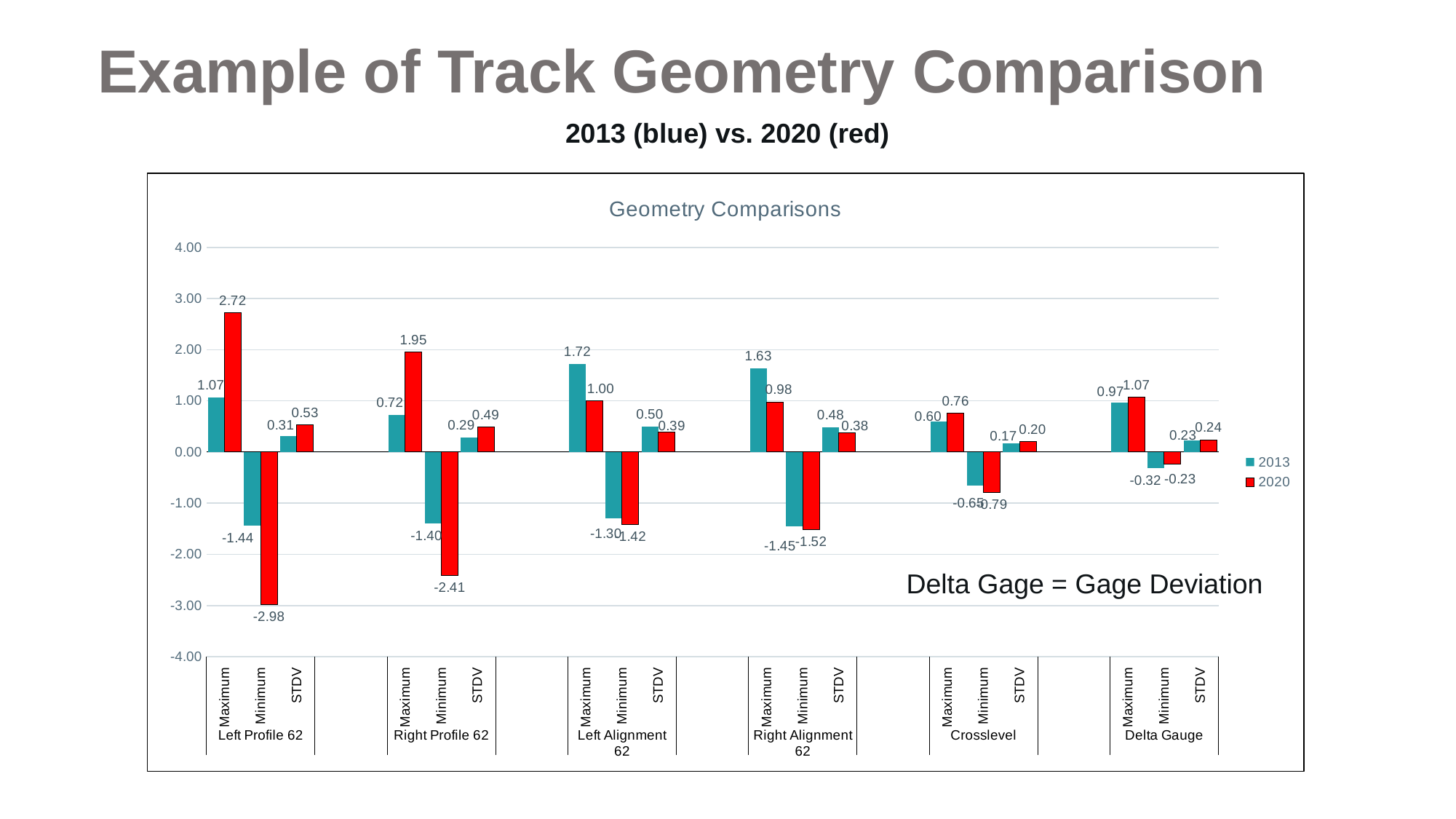
Which group has the lowest 2020 Minimum value? Left Profile 62 How many series does the legend list? 2 How many track geometry groups are shown on the x axis? 6 What is the difference between the 2020 and 2013 Maximum values for Right Profile 62? 1.23 Which group has the highest 2013 Maximum value? Left Alignment 62 What is the 2020 STDV value for Crosslevel? 0.20 What is the difference between the 2013 and 2020 Minimum values for Delta Gauge? 0.09 What is the 2020 Maximum value for Left Profile 62? 2.72 Which is larger for Left Alignment 62 Maximum: the 2013 value or the 2020 value? 2013 What is the 2013 Minimum value for Right Alignment 62? -1.45 What type of chart is shown on the slide? Bar chart What is the chart title? Geometry Comparisons